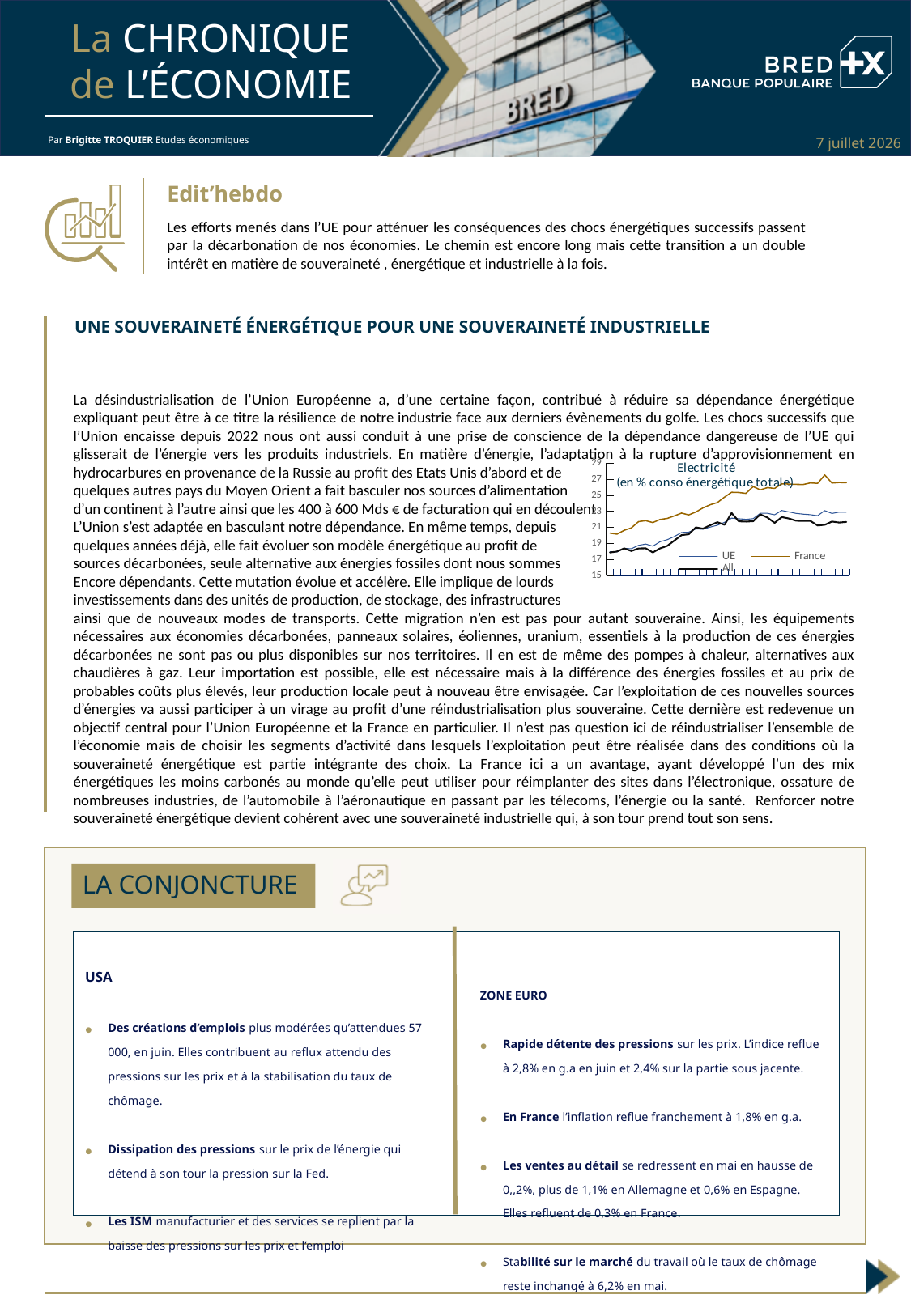
At the right end of the chart, is the value for France greater or less than 25? greater At the left end of the chart, is the value for UE greater or less than 19? less Which series has the highest values at the right end of the chart? France At the left end of the chart, is the value for France greater or less than 19? greater Which series are listed in the chart's legend? UE, France, All What is the title of the chart? Electricité (en % conso énergétique totale) At the right end of the chart, which is larger, the value for France or the value for UE? France Do the values of the France series rise or fall along the x axis overall? rise Do the values of the UE series rise or fall along the x axis overall? rise What kind of chart is shown on the slide? line chart How many series does the legend of the chart list? 3